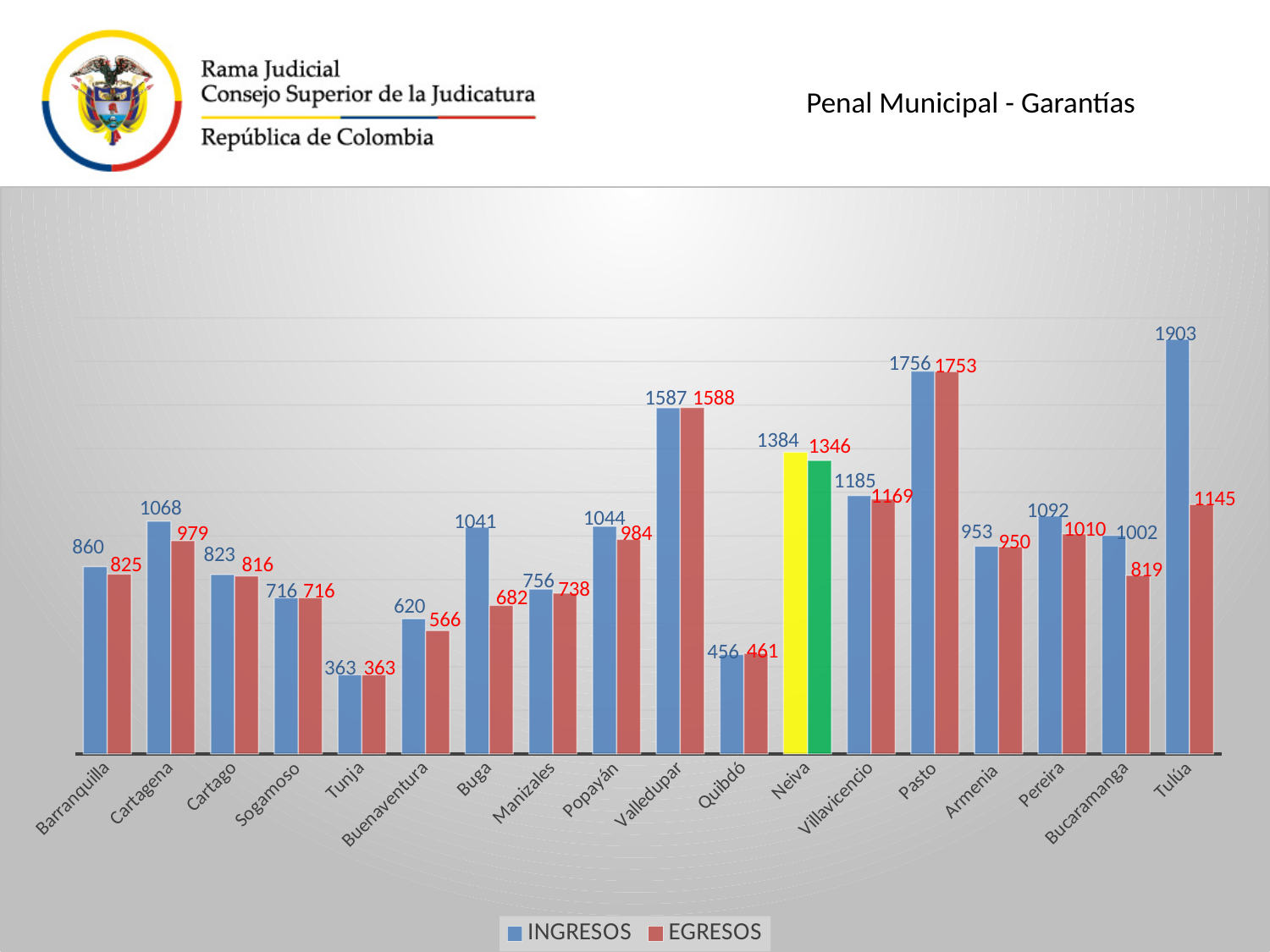
Which city has the highest EGRESOS value? Pasto How many cities are shown on the x axis? 18 What type of chart is shown on the slide? Bar chart Which is larger, the INGRESOS value for Buga or the INGRESOS value for Buenaventura? Buga Which city has the lowest EGRESOS value? Tunja What is the difference between INGRESOS and EGRESOS for Tulúa? 758 How many series does the legend list? 2 What is the INGRESOS value for Neiva? 1384 Which city has the highest INGRESOS value? Tulúa What is the difference between INGRESOS and EGRESOS for Buga? 359 What is the EGRESOS value for Bucaramanga? 819 What is the INGRESOS value for Tulúa? 1903